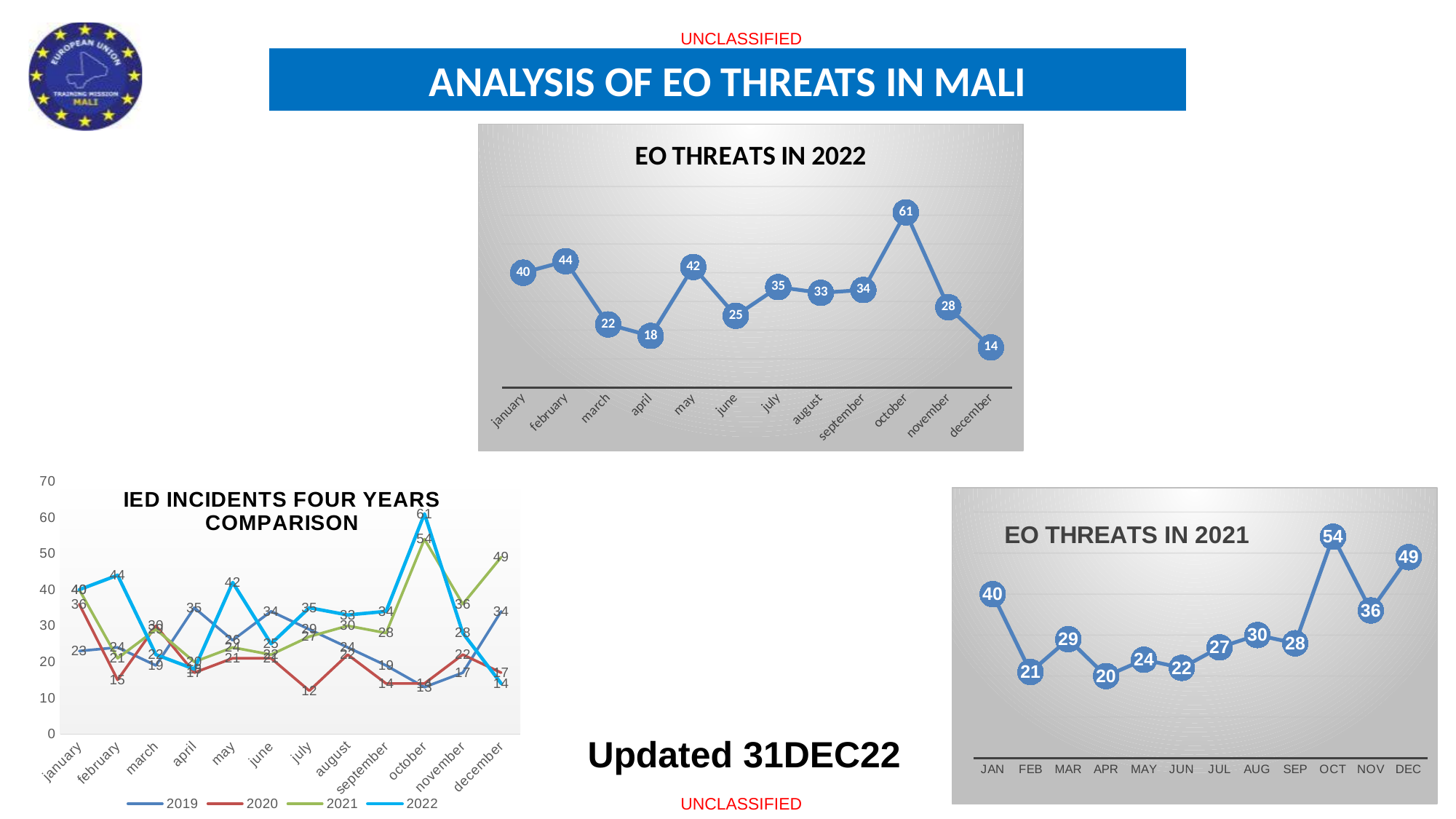
In the EO THREATS IN 2022 chart, what is the difference between the values for february and march? 22 In the EO THREATS IN 2021 chart, what is the difference between the values for DEC and NOV? 13 In the EO THREATS IN 2021 chart, what is the value for APR? 20 In the EO THREATS IN 2021 chart, what is the value for OCT? 54 In the IED INCIDENTS FOUR YEARS COMPARISON chart, how many series does the legend list? 4 In the EO THREATS IN 2021 chart, which month has the highest value? OCT In the IED INCIDENTS FOUR YEARS COMPARISON chart, which years are listed in the legend? 2019, 2020, 2021, 2022 In the EO THREATS IN 2022 chart, which month has the lowest value? december In the EO THREATS IN 2022 chart, how many months are plotted? 12 In the EO THREATS IN 2022 chart, which is larger, the value for may or the value for june? may In the EO THREATS IN 2022 chart, what is the value for october? 61 What kind of chart is the EO THREATS IN 2021 chart? line chart